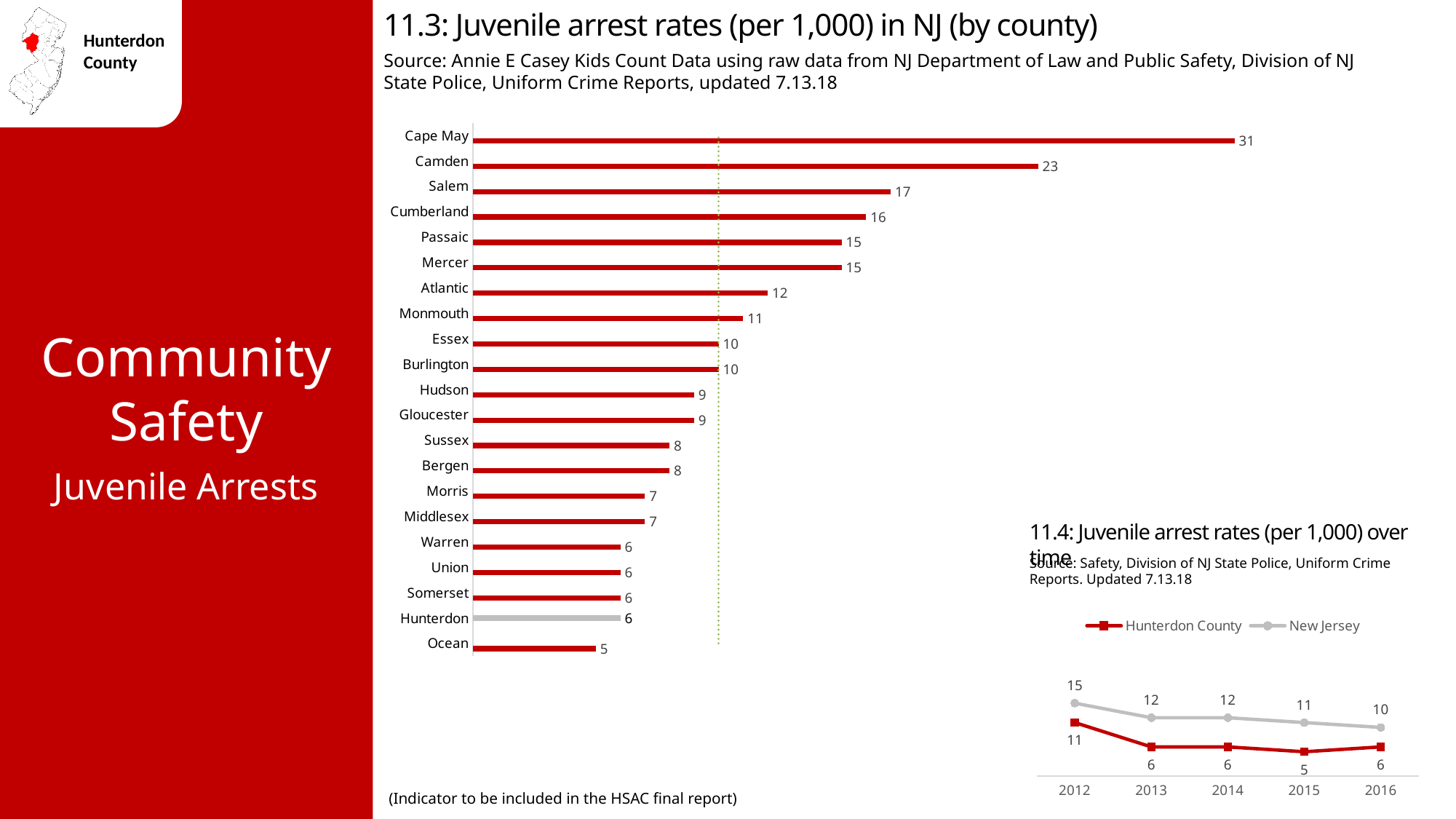
In the chart '11.3: Juvenile arrest rates (per 1,000) in NJ (by county)', which county has the highest value? Cape May In the chart '11.4: Juvenile arrest rates (per 1,000) over time', what is the value for Hunterdon County in 2015? 5 In the chart '11.3: Juvenile arrest rates (per 1,000) in NJ (by county)', what is the value for Hunterdon? 6 In the chart '11.4: Juvenile arrest rates (per 1,000) over time', what is the value for New Jersey in 2012? 15 In the chart '11.3: Juvenile arrest rates (per 1,000) in NJ (by county)', how many counties are shown? 21 In the chart '11.3: Juvenile arrest rates (per 1,000) in NJ (by county)', what is the value for Atlantic? 12 In the chart '11.4: Juvenile arrest rates (per 1,000) over time', does the New Jersey series rise or fall from 2012 to 2016? Fall What kind of chart is '11.3: Juvenile arrest rates (per 1,000) in NJ (by county)'? Bar chart In the chart '11.3: Juvenile arrest rates (per 1,000) in NJ (by county)', which county has the lowest value? Ocean In the chart '11.4: Juvenile arrest rates (per 1,000) over time', how many series does the legend list? 2 In the chart '11.4: Juvenile arrest rates (per 1,000) over time', what is the difference between New Jersey and Hunterdon County in 2016? 4 In the chart '11.3: Juvenile arrest rates (per 1,000) in NJ (by county)', what is the difference between the values for Cape May and Camden? 8